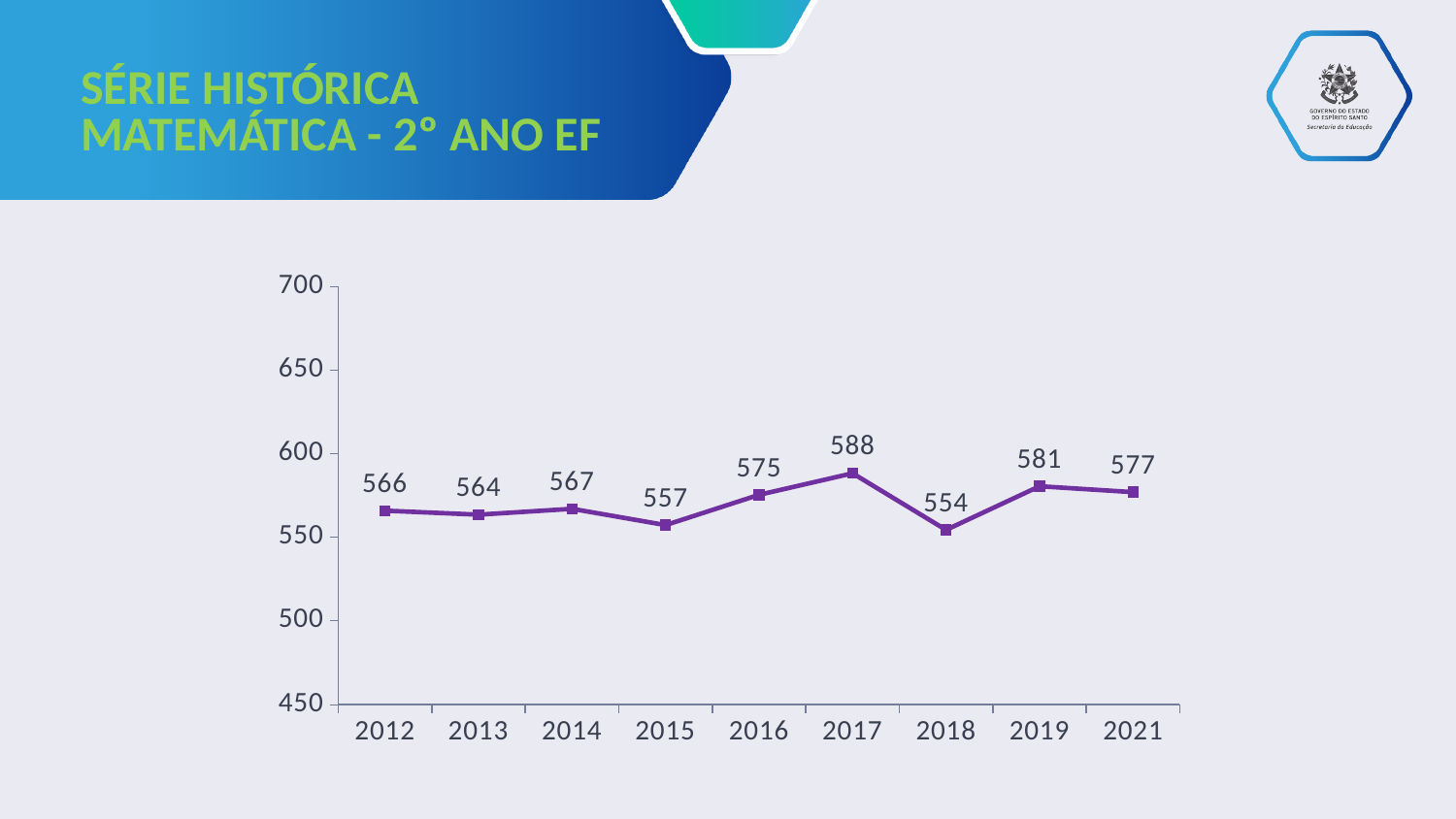
What is the title of the slide? SÉRIE HISTÓRICA MATEMÁTICA - 2° ANO EF Do the values rise or fall from 2018 to 2019? rise What kind of chart is shown on the slide? line chart What is the value for 2021? 577 Is the value for 2015 greater or less than 600? less Which year has the lowest value? 2018 What is the value for 2017? 588 How many years are plotted on the x axis? 9 What is the difference between the values for 2017 and 2018? 34 Which year has the highest value? 2017 What is the value for 2012? 566 Which is larger, the value for 2016 or the value for 2019? 2019